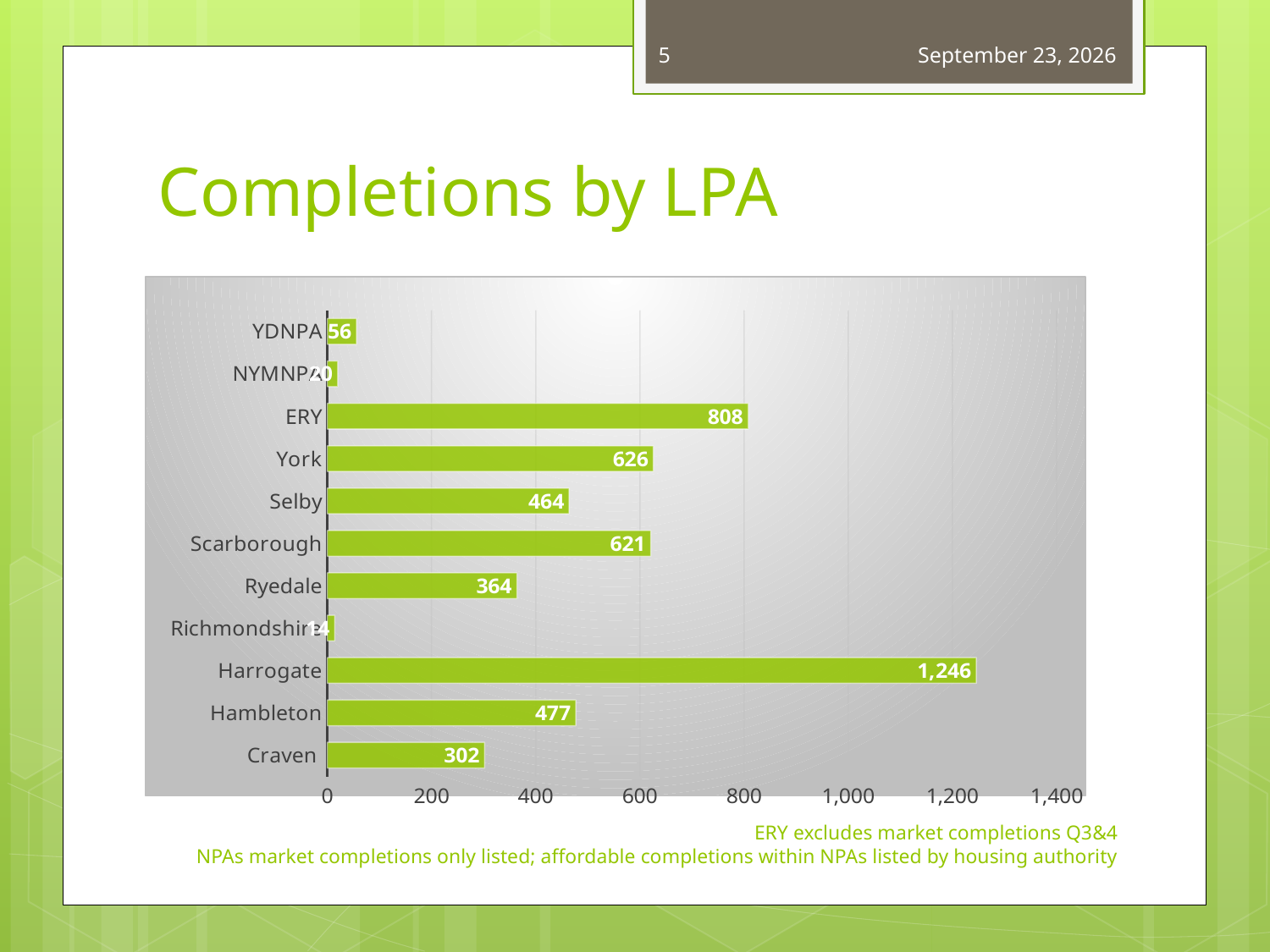
What is the title of the chart? Completions by LPA What type of chart is shown on the slide? bar chart What is the difference between the values for ERY and York? 182 What is the difference between the values for Harrogate and Craven? 944 How many LPAs are listed on the chart? 11 What is the value for ERY? 808 Is the value for Hambleton greater or less than 600? less Which is larger, the value for Selby or the value for Ryedale? Selby What is the value for Ryedale? 364 What is the value for Harrogate? 1,246 What is the value for Craven? 302 Which LPA has the highest number of completions? Harrogate